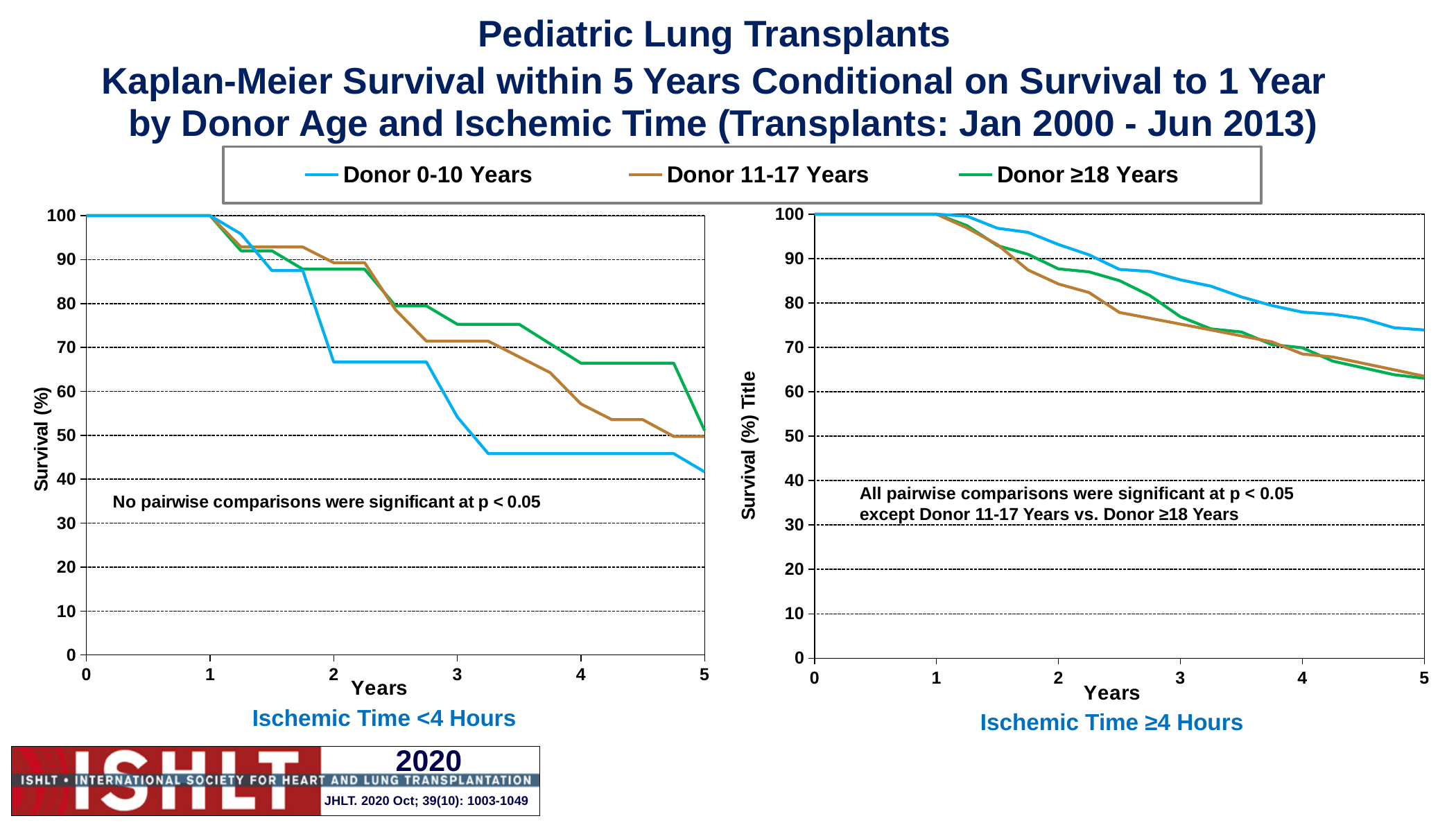
In the 'Ischemic Time ≥4 Hours' chart, which donor age group has the highest survival at year 5? Donor 0-10 Years What is the x-axis label of the 'Ischemic Time <4 Hours' chart? Years In the 'Ischemic Time <4 Hours' chart, which donor age group has the lowest survival at year 5? Donor 0-10 Years In the 'Ischemic Time ≥4 Hours' chart, is the survival for Donor 0-10 Years at year 3 larger or smaller than that for Donor 11-17 Years at year 3? larger In the 'Ischemic Time <4 Hours' chart, which donor age group has the highest survival at year 4? Donor ≥18 Years In the 'Ischemic Time <4 Hours' chart, what is the survival (%) for Donor 0-10 Years at year 1? 100 What kind of chart is shown under 'Ischemic Time <4 Hours'? line chart In the 'Ischemic Time <4 Hours' chart, is the survival for Donor ≥18 Years at year 4 greater or less than 60? greater How many series does the legend list? 3 In the 'Ischemic Time ≥4 Hours' chart, is the survival for Donor 0-10 Years at year 5 greater or less than 70? greater In the 'Ischemic Time ≥4 Hours' chart, do the survival curves rise or fall as years increase? fall In the 'Ischemic Time <4 Hours' chart, is the survival for Donor 0-10 Years at year 5 greater or less than 50? less